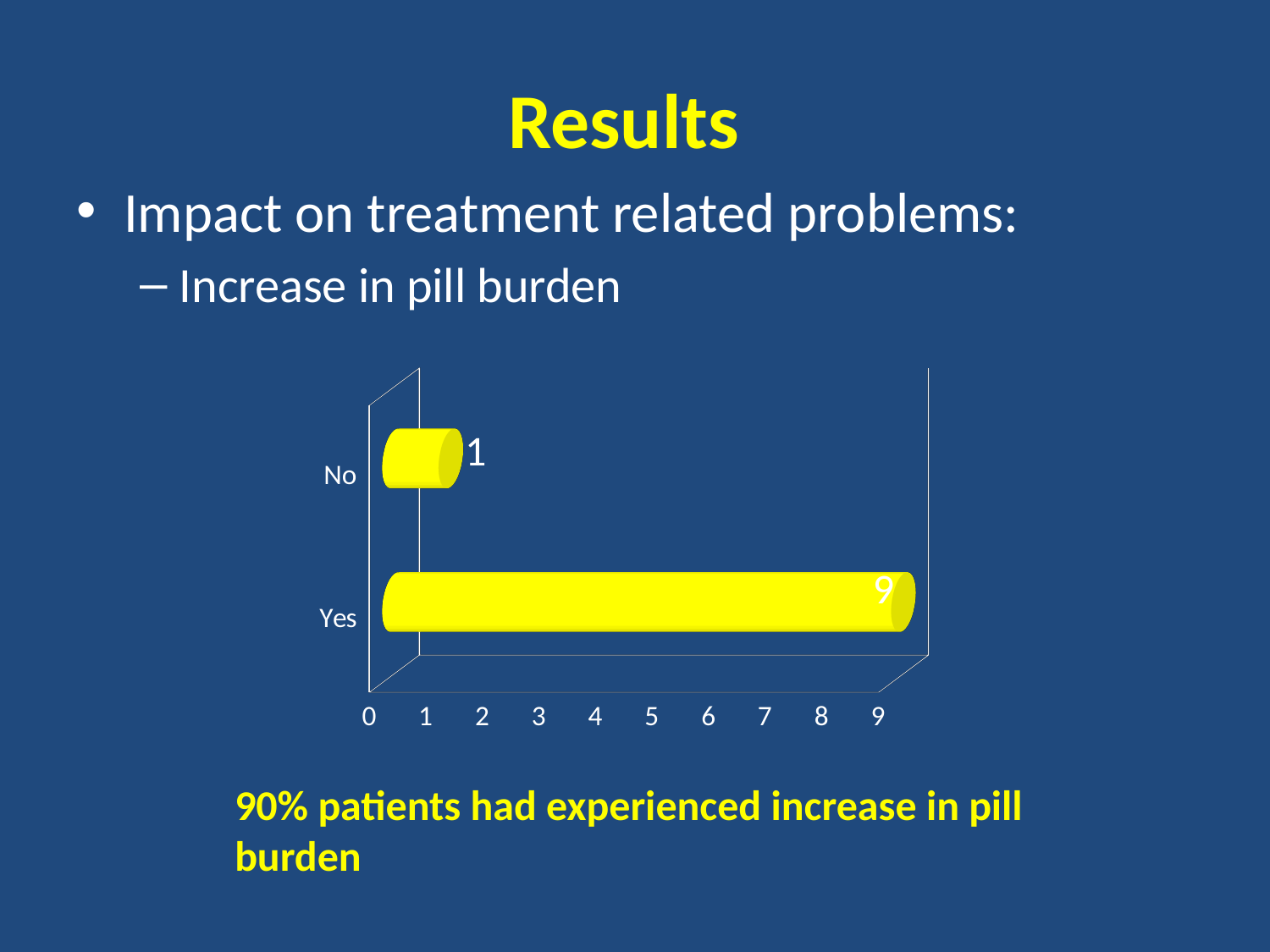
How many categories are shown in the chart? 2 Which category has the highest value? Yes What is the value for Yes? 9 What kind of chart is shown on the slide? bar chart Is the value for Yes greater or less than 5? greater What colour are the bars in the chart? yellow Which category has the lowest value? No What is the difference between the values for Yes and No? 8 Which is larger, the value for Yes or the value for No? Yes What is the value for No? 1 Is the value for No greater or less than 5? less What is the total of the values for Yes and No? 10